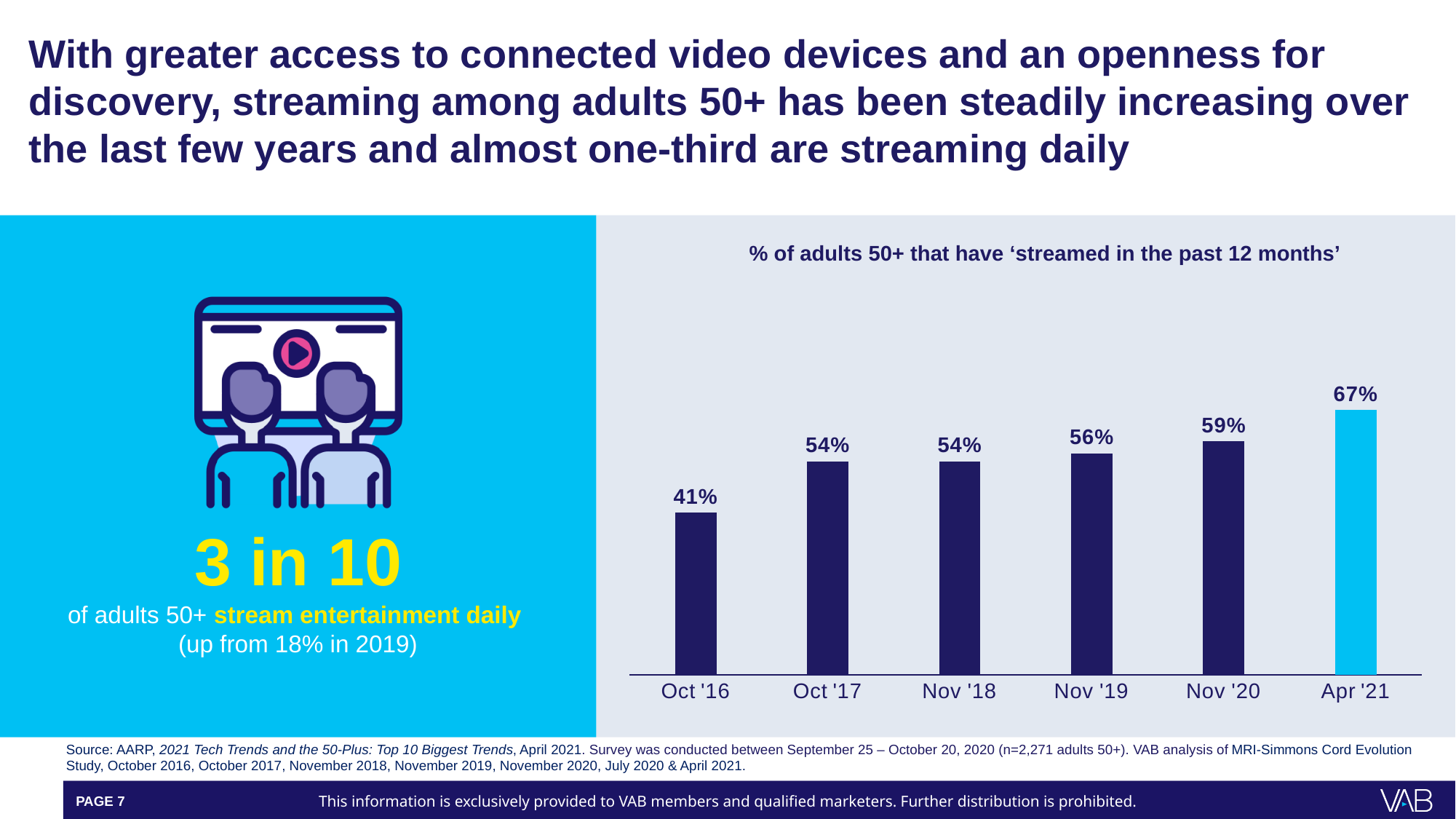
What is the difference between the values for Nov '20 and Nov '19? 3% Which is larger, the value for Nov '20 or the value for Oct '17? Nov '20 What is the difference between the values for Apr '21 and Oct '16? 26% Which period has the highest value? Apr '21 How many periods are shown on the x axis? 6 Do the values generally rise or fall from Oct '16 to Apr '21? Rise Which period has the lowest value? Oct '16 What is the title of the chart? % of adults 50+ that have 'streamed in the past 12 months' What is the value for Nov '19? 56% What is the value for Oct '16? 41% What kind of chart is shown? Bar chart What is the value for Apr '21? 67%